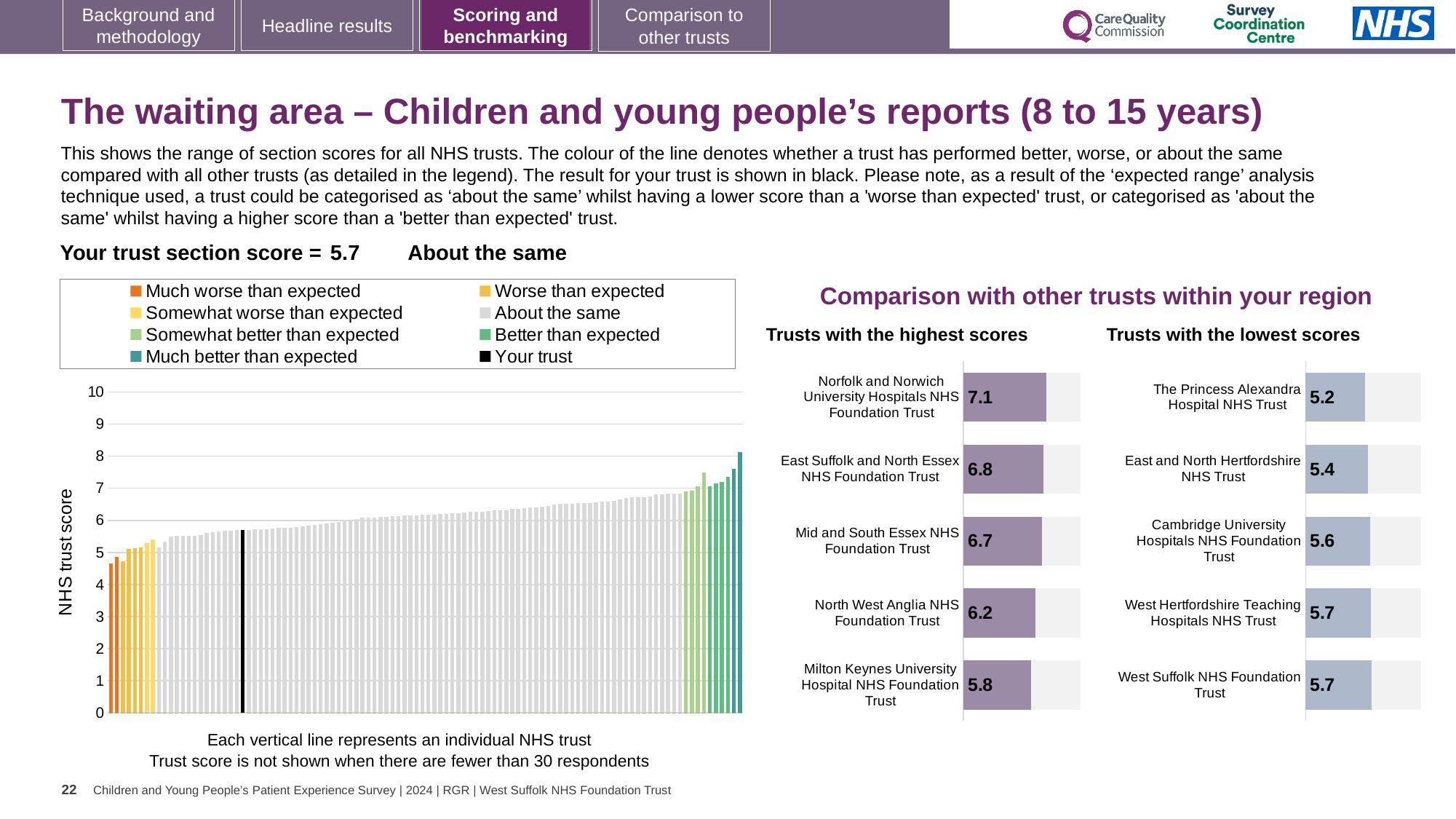
In the large 'NHS trust score' chart on the left, is the value of the black bar (your trust) greater or less than 6? less In the large 'NHS trust score' chart on the left, how many entries does the legend list? 8 In the 'Trusts with the lowest scores' chart, which has the larger score: East and North Hertfordshire NHS Trust or Cambridge University Hospitals NHS Foundation Trust? Cambridge University Hospitals NHS Foundation Trust In the 'Trusts with the highest scores' chart, which trust has the highest score? Norfolk and Norwich University Hospitals NHS Foundation Trust In the 'Trusts with the highest scores' chart, what is the score for Norfolk and Norwich University Hospitals NHS Foundation Trust? 7.1 In the 'Trusts with the lowest scores' chart, which trust has the lowest score? The Princess Alexandra Hospital NHS Trust In the 'Trusts with the highest scores' chart, how many trusts are shown? 5 In the 'Trusts with the highest scores' chart, what is the score for Milton Keynes University Hospital NHS Foundation Trust? 5.8 In the 'Trusts with the lowest scores' chart, what is the difference between the scores of Cambridge University Hospitals NHS Foundation Trust and The Princess Alexandra Hospital NHS Trust? 0.4 In the large 'NHS trust score' chart on the left, what kind of chart is it? Bar chart In the 'Trusts with the highest scores' chart, what is the difference between the scores of Norfolk and Norwich University Hospitals NHS Foundation Trust and Milton Keynes University Hospital NHS Foundation Trust? 1.3 In the 'Trusts with the lowest scores' chart, what is the score for The Princess Alexandra Hospital NHS Trust? 5.2